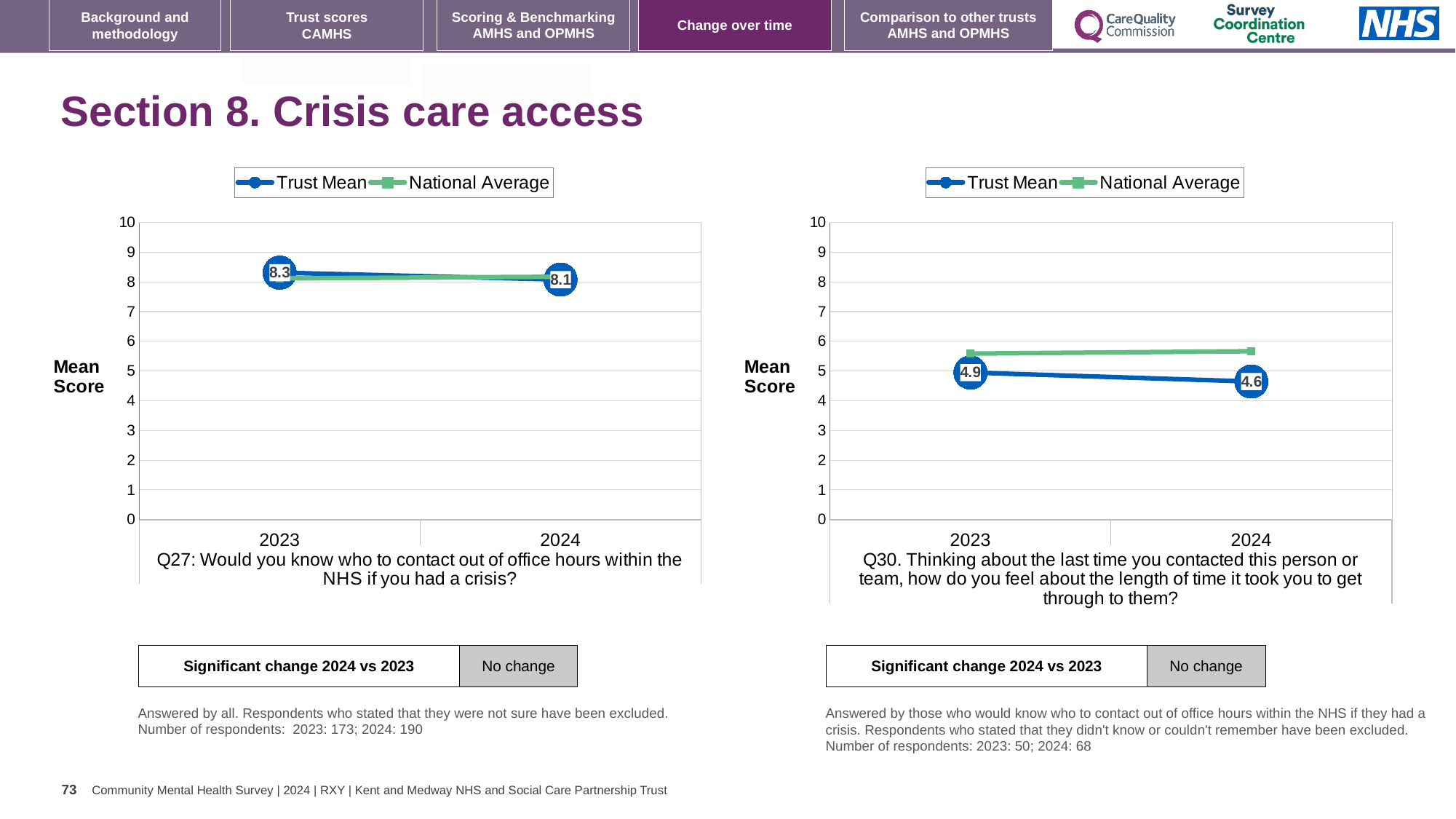
In the left chart (Q27), by how much did the Trust Mean change from 2023 to 2024? 0.2 In the right chart (Q30), is the National Average for 2023 greater or less than 5? greater In the right chart (Q30), what is the difference between the Trust Mean in 2023 and 2024? 0.3 In the left chart (Q27), what is the Trust Mean score for 2024? 8.1 In the right chart (Q30), does the Trust Mean rise or fall from 2023 to 2024? fall In the right chart (Q30), which series is higher in 2024, Trust Mean or National Average? National Average What type of chart is the left chart (Q27)? line chart How many series does the legend of the right chart (Q30) list? 2 How many years are shown on the x axis of the left chart (Q27)? 2 In the right chart (Q30), what is the Trust Mean score for 2023? 4.9 In the left chart (Q27), what is the Trust Mean score for 2023? 8.3 In the right chart (Q30), what is the Trust Mean score for 2024? 4.6